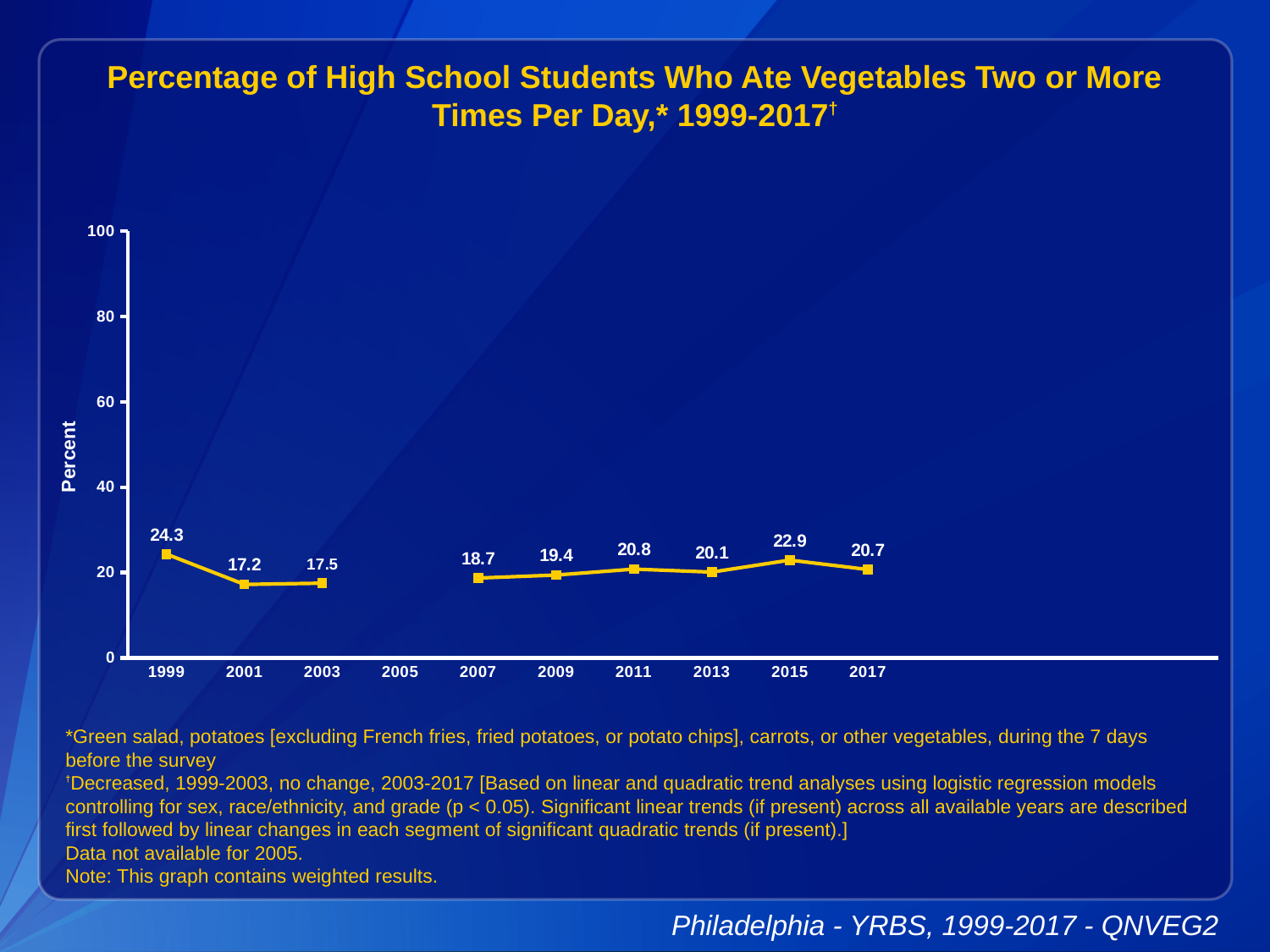
What percentage of high school students ate vegetables two or more times per day in 1999? 24.3 Which year has a larger value, 2011 or 2013? 2011 Which year has the highest value on the chart? 1999 How many years have data points plotted on the chart? 9 What kind of chart is shown on the slide? Line chart What is the difference between the values for 1999 and 2001? 7.1 Is the value for 2015 greater or less than 20? greater What is the label on the vertical axis? Percent Which year has the lowest value on the chart? 2001 What is the value plotted for 2017? 20.7 What is the value plotted for 2007? 18.7 What is the difference between the values for 2015 and 2013? 2.8